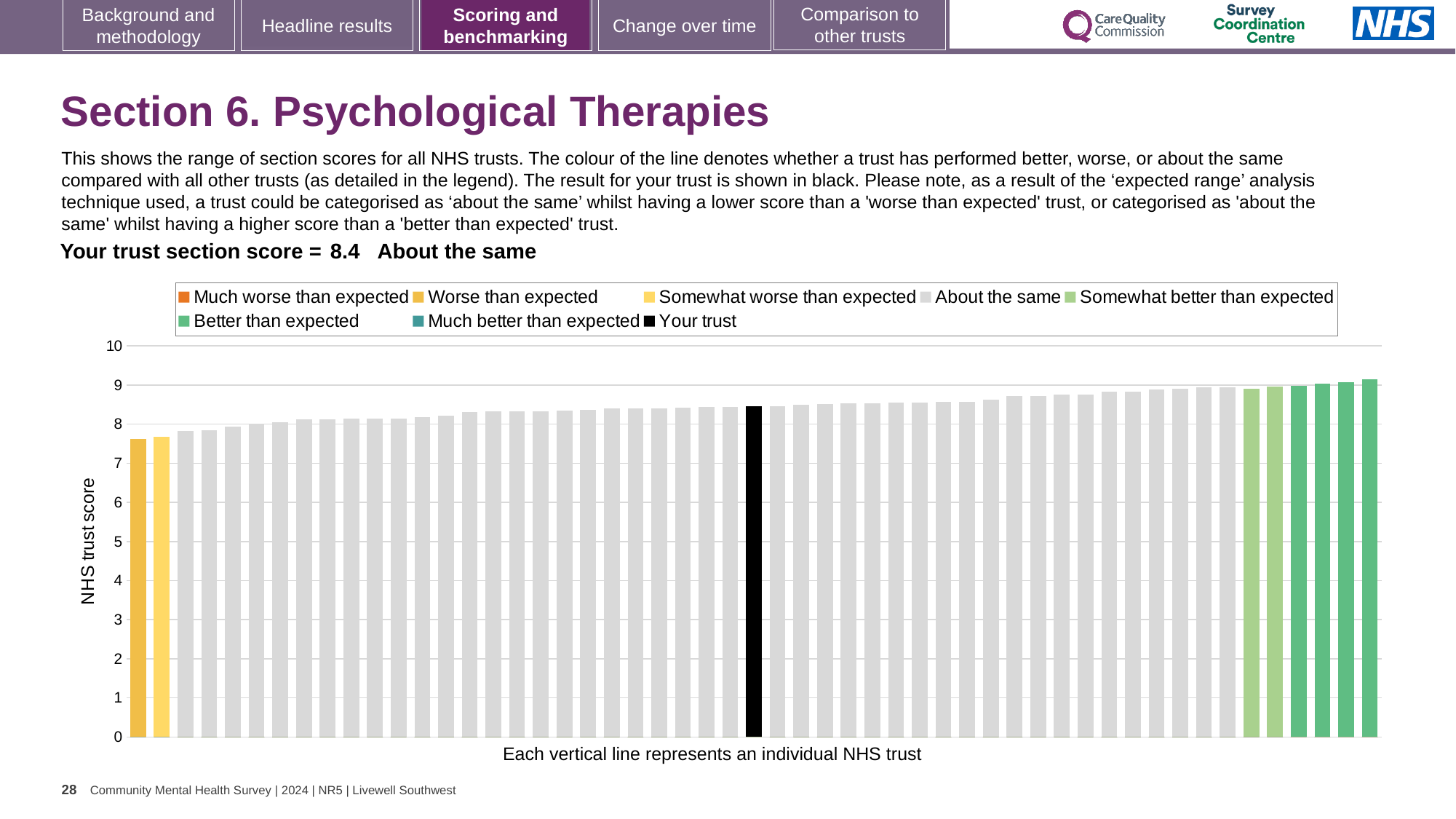
What is the label on the vertical axis of the chart? NHS trust score Is the value for your trust (the black bar) greater or less than 8? greater Do the bar values rise or fall from left to right along the x axis? rise Which performance category is your trust placed in for Section 6? About the same Is the value of the leftmost bar greater or less than 8? less Which is larger, the leftmost bar or the rightmost bar? the rightmost bar Is the value of the leftmost bar greater or less than 7? greater What kind of chart is shown on the slide? bar chart How many entries does the chart legend list? 8 What is the section score for your trust shown on the slide? 8.4